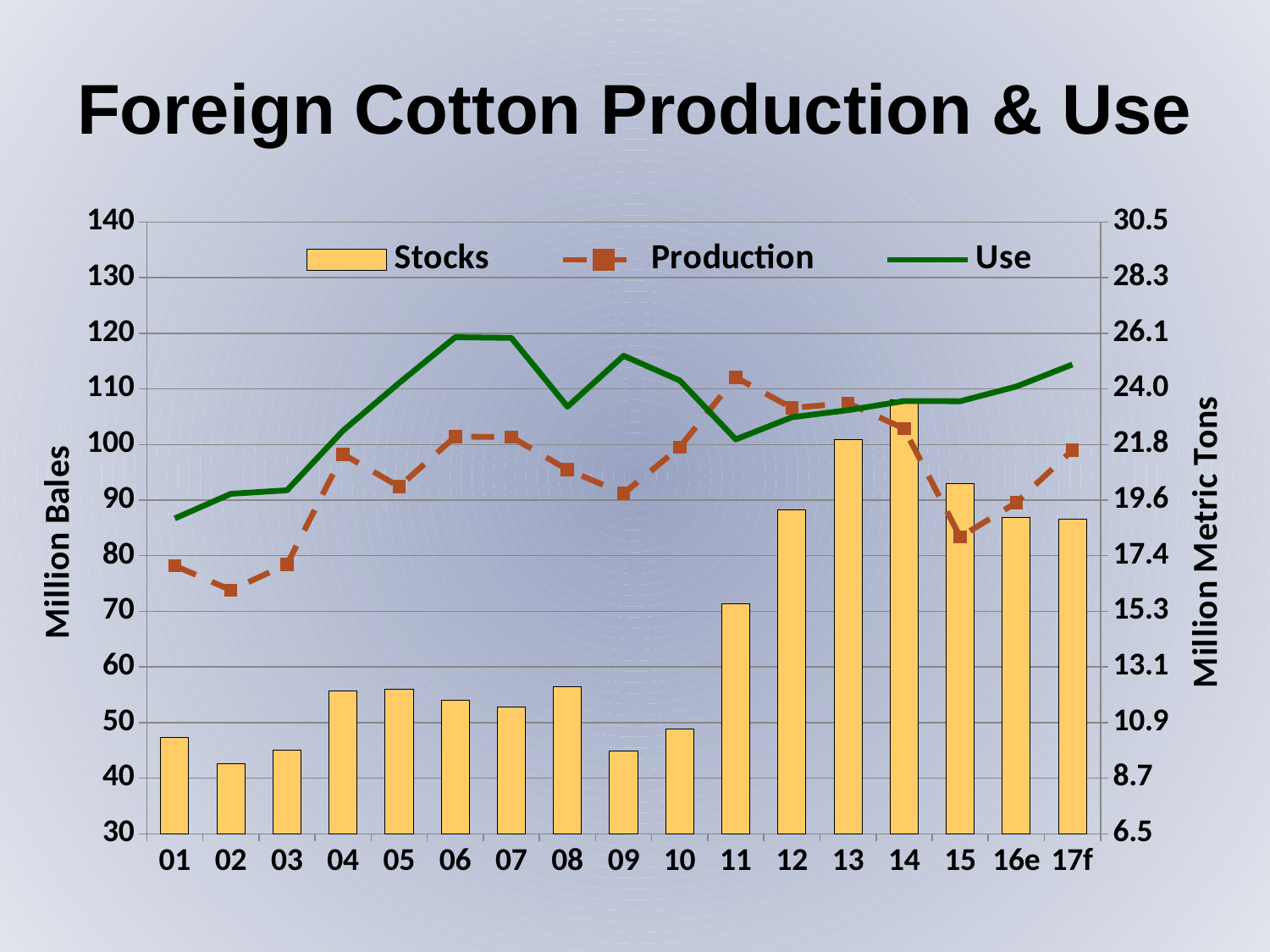
How many years are shown on the x axis? 17 Which year has the lowest Stocks bar? 02 Is the Stocks value for 14 greater or less than 100 million bales? greater Is the Use value for 06 greater or less than 110 on the left axis? greater In which year is the Use line at its lowest? 01 Do the Stocks bars rise or fall from 11 to 14? rise Which is larger, the Stocks bar for 12 or the Stocks bar for 13? 13 In which year does the Production line reach its highest point? 11 What kind of chart is shown on the slide? A combination bar and line chart Which year has the highest Stocks bar? 14 Is the Stocks value for 02 greater or less than 50 million bales? less How many series does the legend list? 3